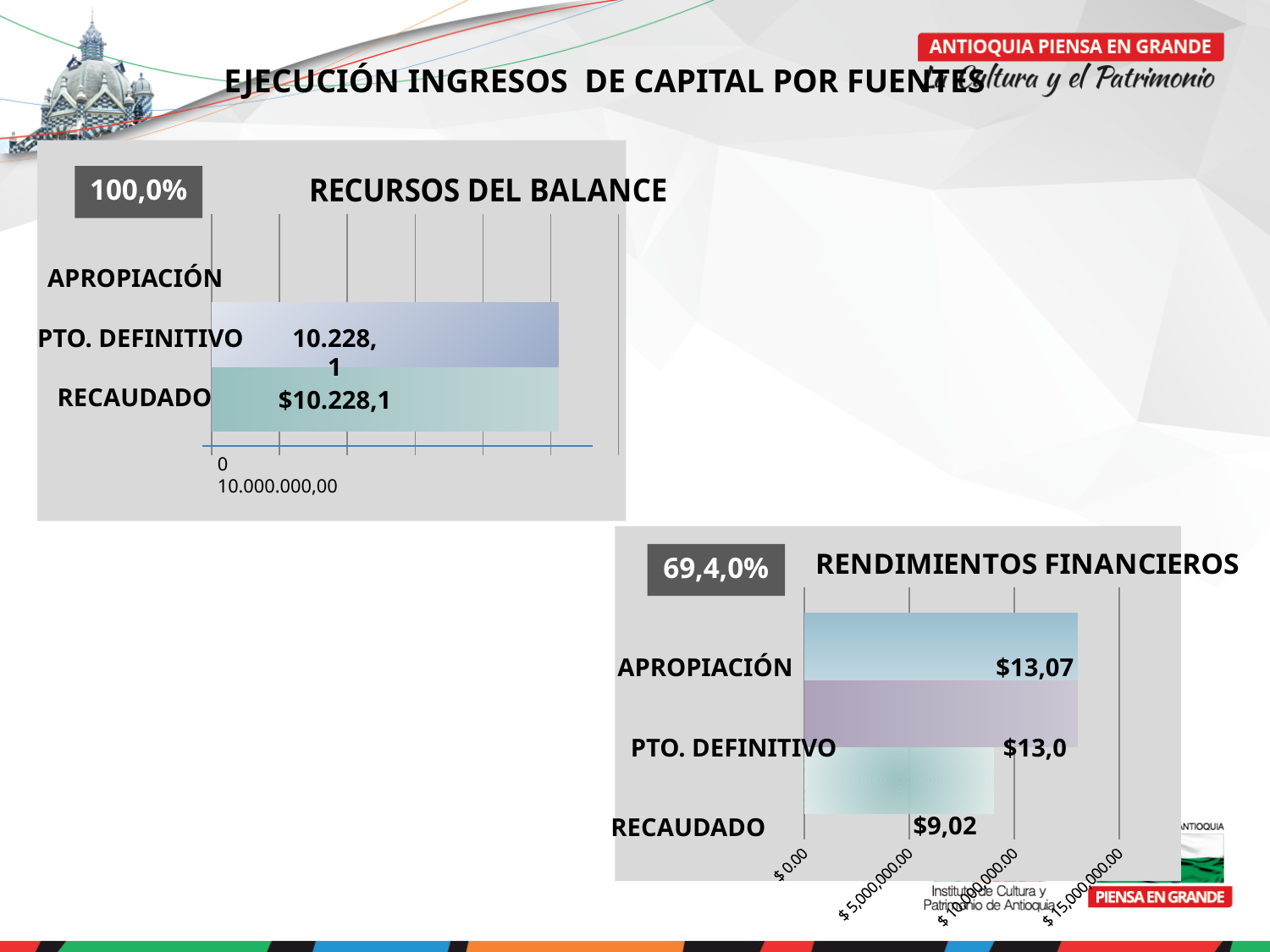
How many categories are shown in the RENDIMIENTOS FINANCIEROS chart? 3 What percentage is shown in the badge next to the RENDIMIENTOS FINANCIEROS chart title? 69,4,0% In the RECURSOS DEL BALANCE chart, what is the value for RECAUDADO? $10.228,1 In the RENDIMIENTOS FINANCIEROS chart, is the value for APROPIACIÓN greater or less than $10,000,000.00? greater In the RENDIMIENTOS FINANCIEROS chart, which is larger: APROPIACIÓN or RECAUDADO? APROPIACIÓN In the RENDIMIENTOS FINANCIEROS chart, which category has the lowest value? RECAUDADO In the RENDIMIENTOS FINANCIEROS chart, what is the value for PTO. DEFINITIVO? $13,0 In the RENDIMIENTOS FINANCIEROS chart, what is the value for APROPIACIÓN? $13,07 What percentage is shown in the badge next to the RECURSOS DEL BALANCE chart title? 100,0% What kind of chart is the RENDIMIENTOS FINANCIEROS chart? bar chart In the RENDIMIENTOS FINANCIEROS chart, what is the value for RECAUDADO? $9,02